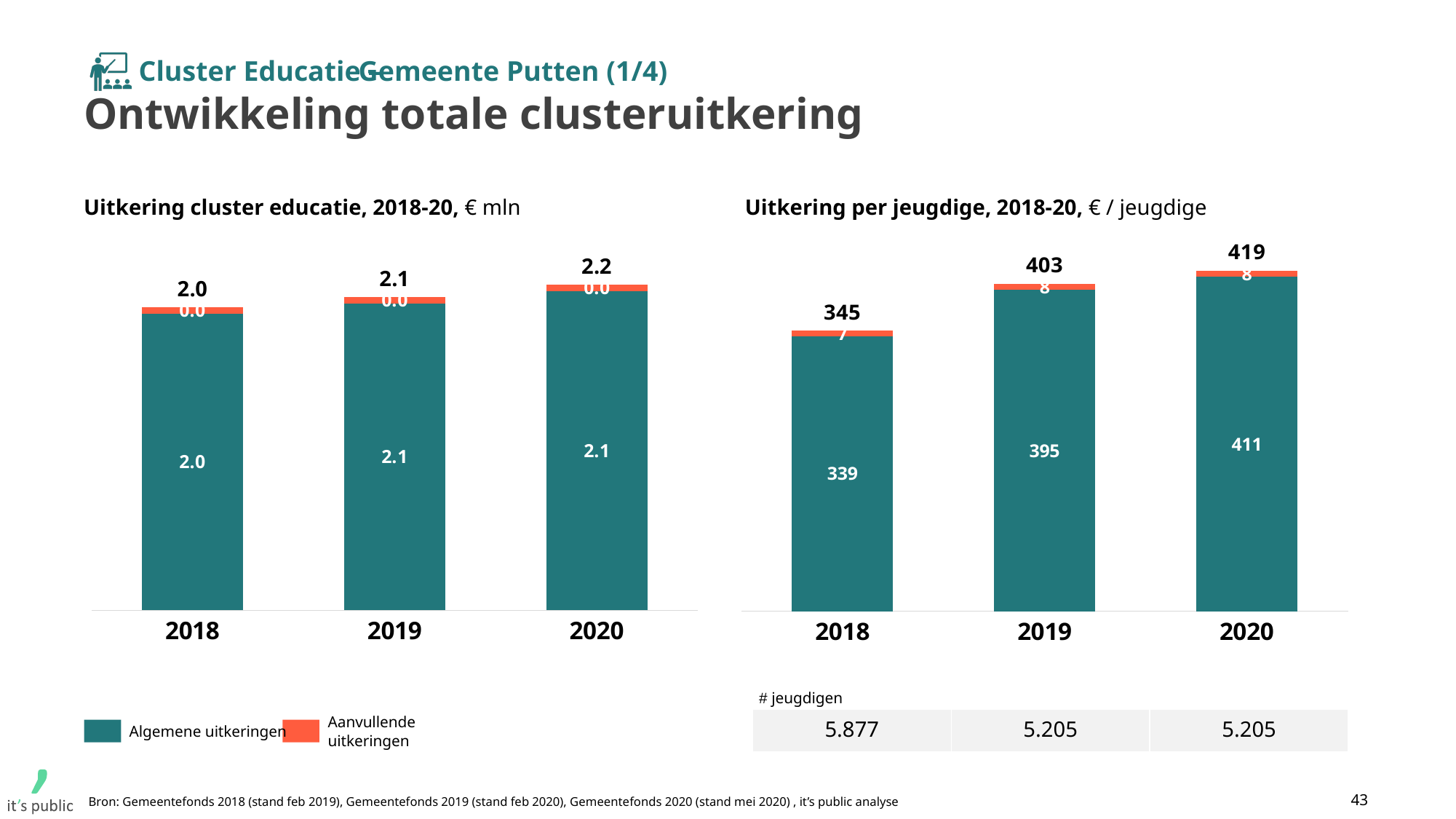
In the 'Uitkering per jeugdige, 2018-20' chart, what is the difference between the 2020 total and the 2018 total? 74 In the 'Uitkering per jeugdige, 2018-20' chart, what is the total value shown above the 2020 bar? 419 In the 'Uitkering cluster educatie, 2018-20' chart, what is the total value shown above the 2019 bar? 2.1 In the 'Uitkering per jeugdige, 2018-20' chart, what is the Algemene uitkeringen value for 2018? 339 How many years are shown on the x axis of the 'Uitkering cluster educatie, 2018-20' chart? 3 In the 'Uitkering per jeugdige, 2018-20' chart, what is the Aanvullende uitkeringen value for 2019? 8 In the 'Uitkering per jeugdige, 2018-20' chart, is the Algemene uitkeringen value larger in 2019 or in 2020? 2020 How many series does the legend list for the charts on this slide? 2 In the 'Uitkering cluster educatie, 2018-20' chart, what is the Algemene uitkeringen value for 2020? 2.1 In the 'Uitkering cluster educatie, 2018-20' chart, which year has the highest total? 2020 In the 'Uitkering per jeugdige, 2018-20' chart, which year has the lowest total? 2018 Do the totals in the 'Uitkering per jeugdige, 2018-20' chart rise or fall from 2018 to 2020? rise